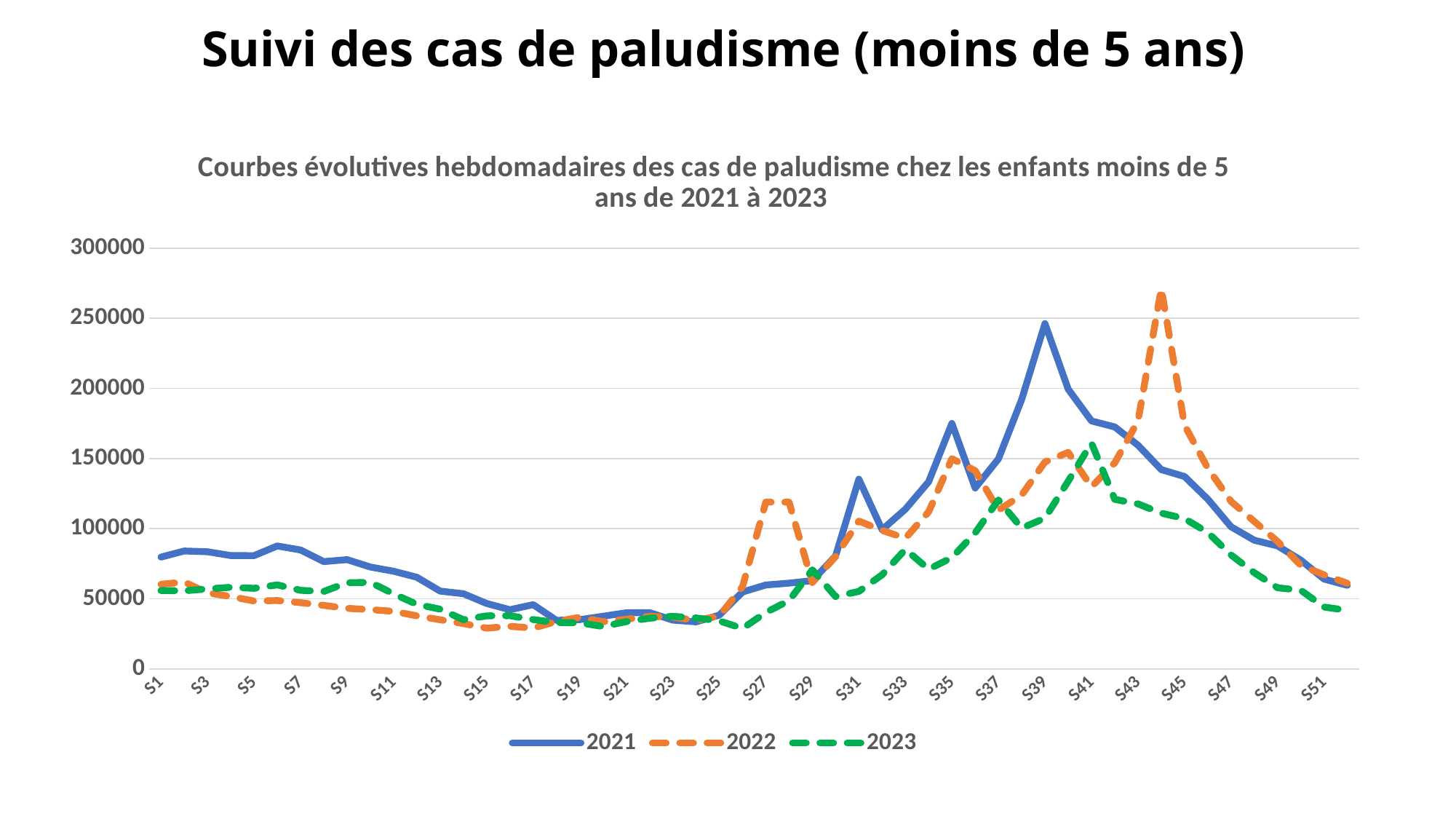
Which series has the lowest value at S27? 2023 Does the 2021 series rise or fall from S1 to S17? fall What is the title printed above the chart? Courbes évolutives hebdomadaires des cas de paludisme chez les enfants moins de 5 ans de 2021 à 2023 What are the series names listed in the legend? 2021, 2022, 2023 Which series reaches the highest peak value on the chart? 2022 Is the peak value of the 2022 series greater or less than 250000? greater Is the peak value of the 2023 series greater or less than 200000? less Is the peak value of the 2021 series greater or less than 200000? greater How many series does the legend list? 3 At S1, which series has the higher value, 2021 or 2023? 2021 What kind of chart is shown on the slide? line chart